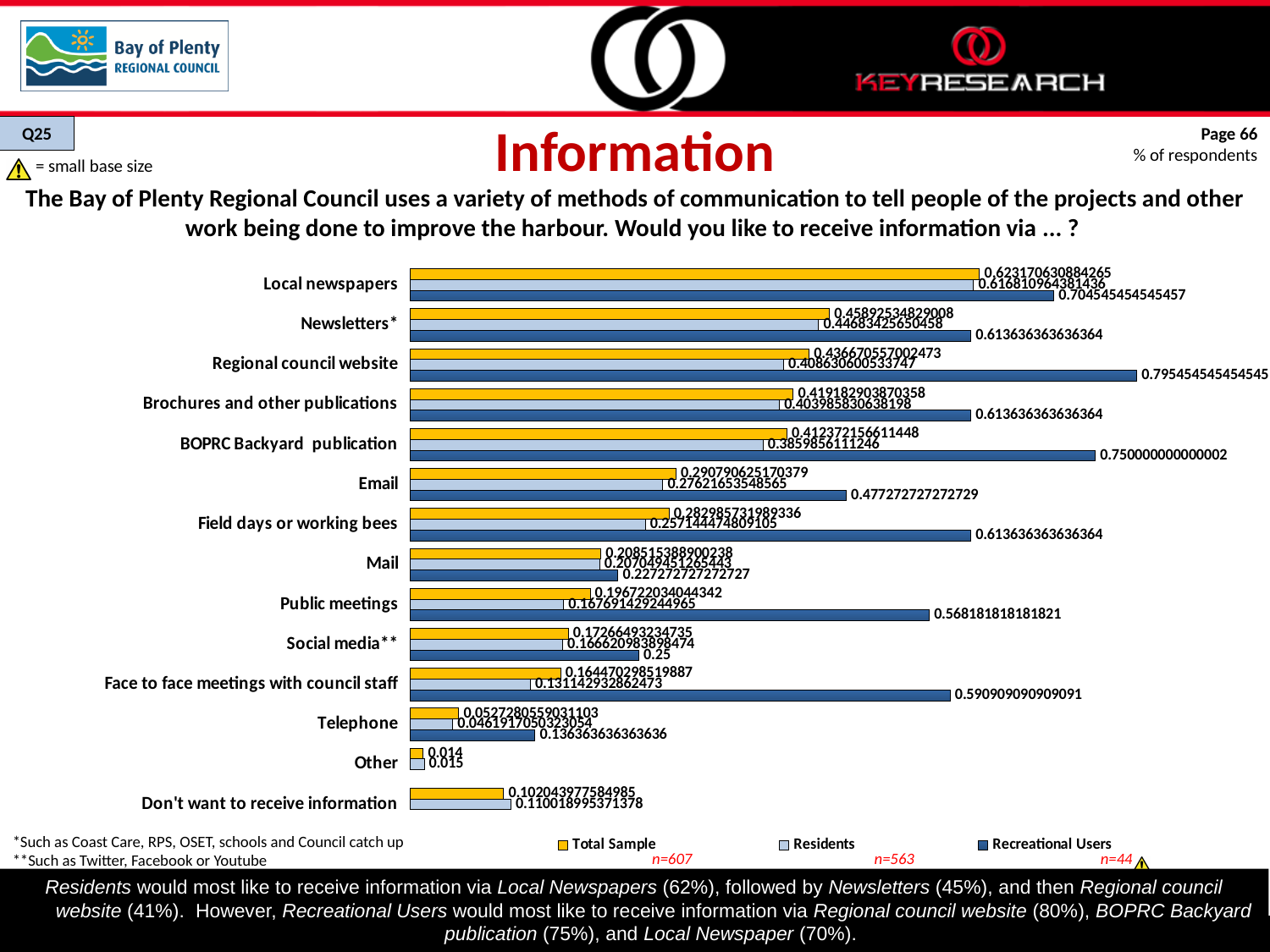
What type of chart is shown on the slide? bar chart What is the Recreational Users value for Social media**? 0.25 What is the Recreational Users value for BOPRC Backyard publication? 0.750000000000002 How many series does the legend list? 3 Which category has the highest Total Sample value? Local newspapers How many categories are plotted on the chart? 14 What is the sample size (n) shown for the Total Sample series in the legend? n=607 What is the Total Sample value for Local newspapers? 0.623170630884265 What is the Recreational Users value for Regional council website? 0.795454545454545 What is the Total Sample value for Other? 0.014 Which category has the highest Recreational Users value? Regional council website For Recreational Users, which is larger: Regional council website or Public meetings? Regional council website